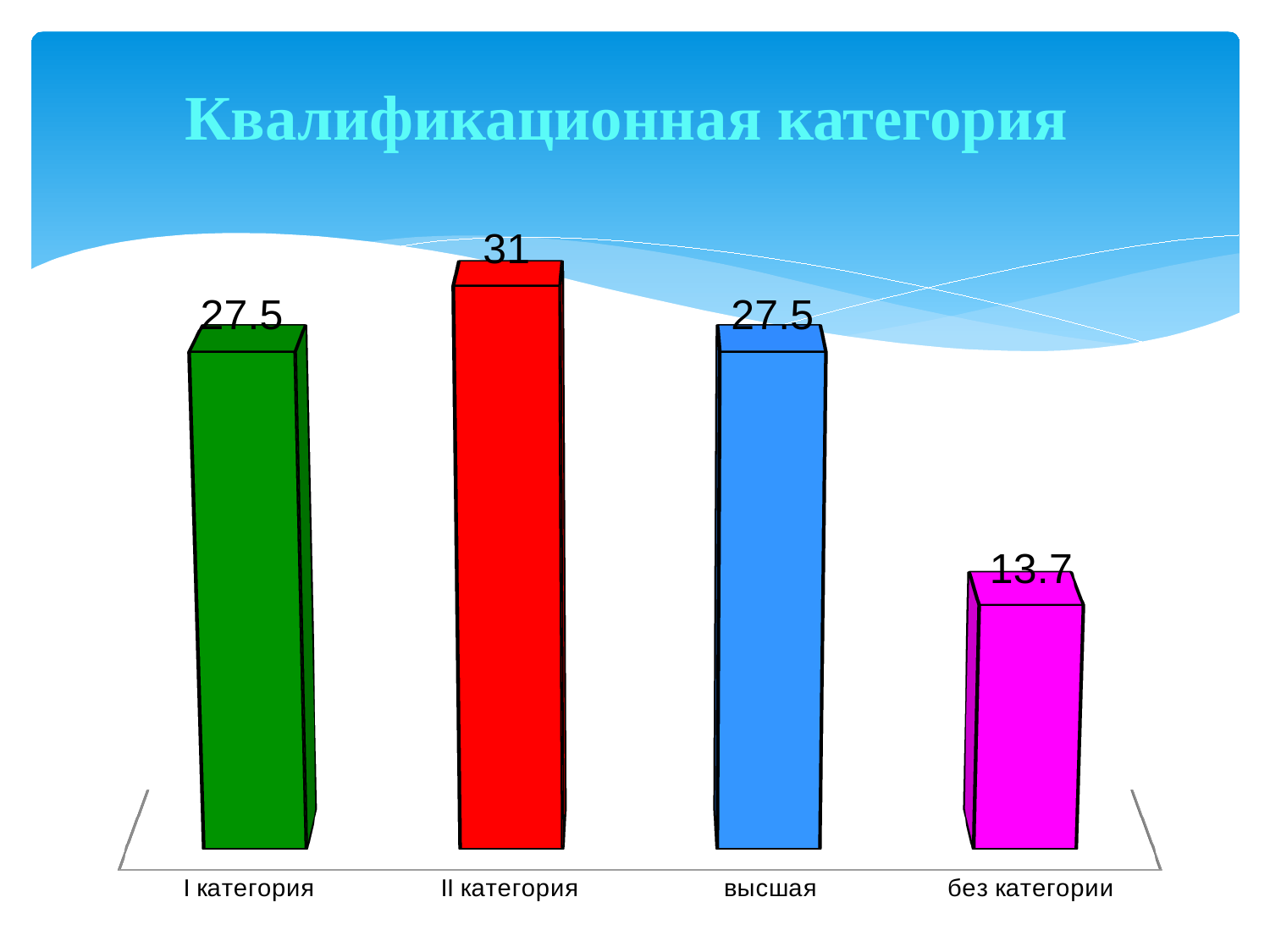
What is the difference between the values for II категория and высшая? 3.5 What is the difference between the values for II категория and без категории? 17.3 Which category has the highest value? II категория What is the value for без категории? 13.7 How many categories are shown in the chart? 4 What is the value for II категория? 31 What is the title of the chart? Квалификационная категория What is the value for I категория? 27.5 What is the value for высшая? 27.5 What kind of chart is shown on the slide? bar chart Which is larger, the value for I категория or the value for без категории? I категория Which category has the lowest value? без категории